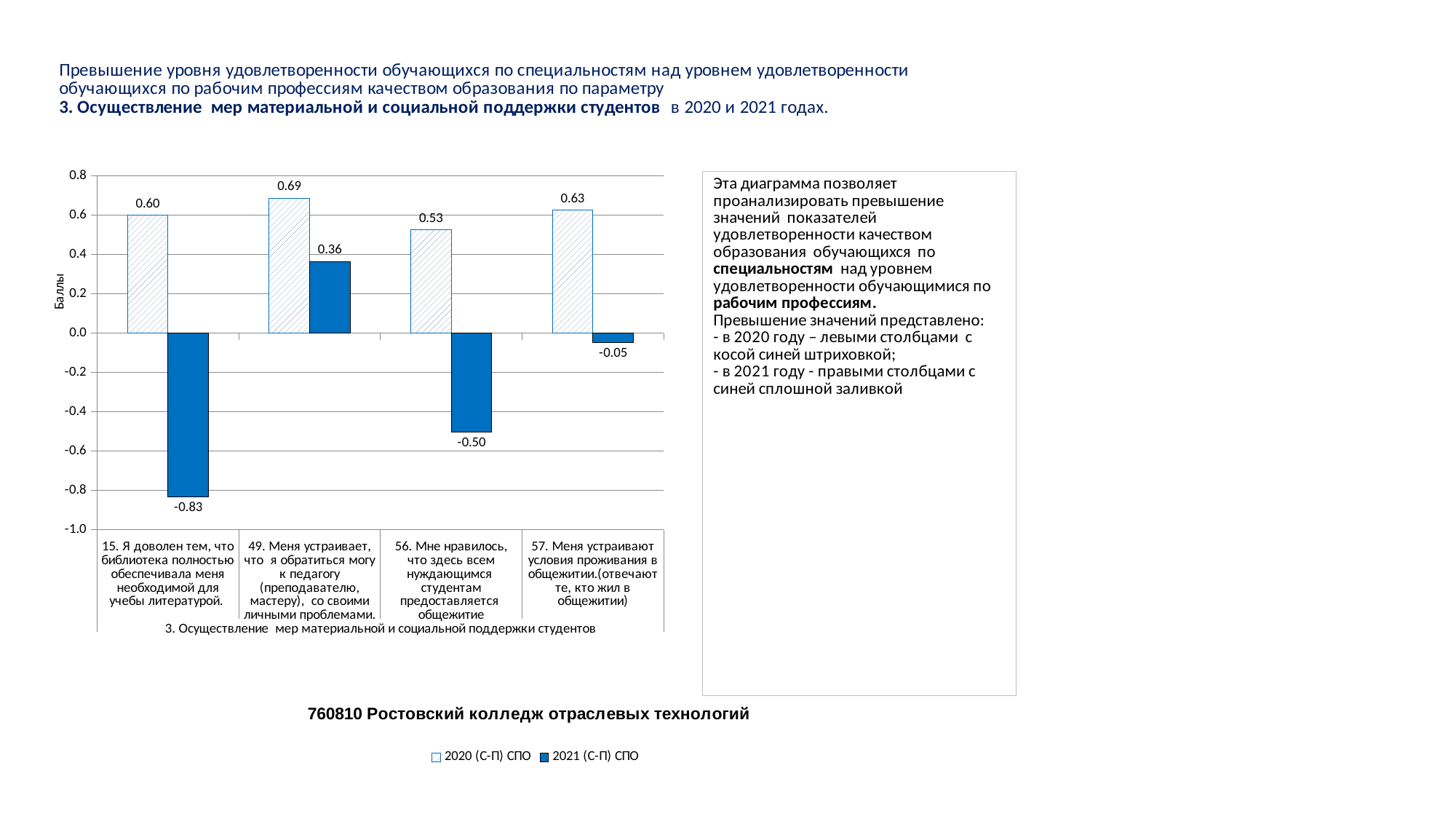
Which category has the highest value in the 2020 (С-П) СПО series? 49. Меня устраивает, что я обратиться могу к педагогу (преподавателю, мастеру), со своими личными проблемами. What is the value of the 2021 (С-П) СПО series for category 15 (Я доволен тем, что библиотека полностью обеспечивала меня необходимой для учебы литературой)? -0.83 How many series does the chart legend list? 2 What is the value of the 2021 (С-П) СПО series for category 57 (Меня устраивают условия проживания в общежитии)? -0.05 What is the value of the 2020 (С-П) СПО series for category 49 (Меня устраивает, что я обратиться могу к педагогу)? 0.69 What type of chart is shown on the slide? Bar chart What is the label of the vertical axis of the chart? Баллы What is the value of the 2020 (С-П) СПО series for category 56 (Мне нравилось, что здесь всем нуждающимся студентам предоставляется общежитие)? 0.53 How many categories are shown on the x axis of the chart? 4 What is the difference between the 2020 and 2021 values for category 49 (Меня устраивает, что я обратиться могу к педагогу)? 0.33 Which category has the lowest value in the 2021 (С-П) СПО series? 15. Я доволен тем, что библиотека полностью обеспечивала меня необходимой для учебы литературой. Which is larger for category 56: the 2020 (С-П) СПО value or the 2021 (С-П) СПО value? 2020 (С-П) СПО